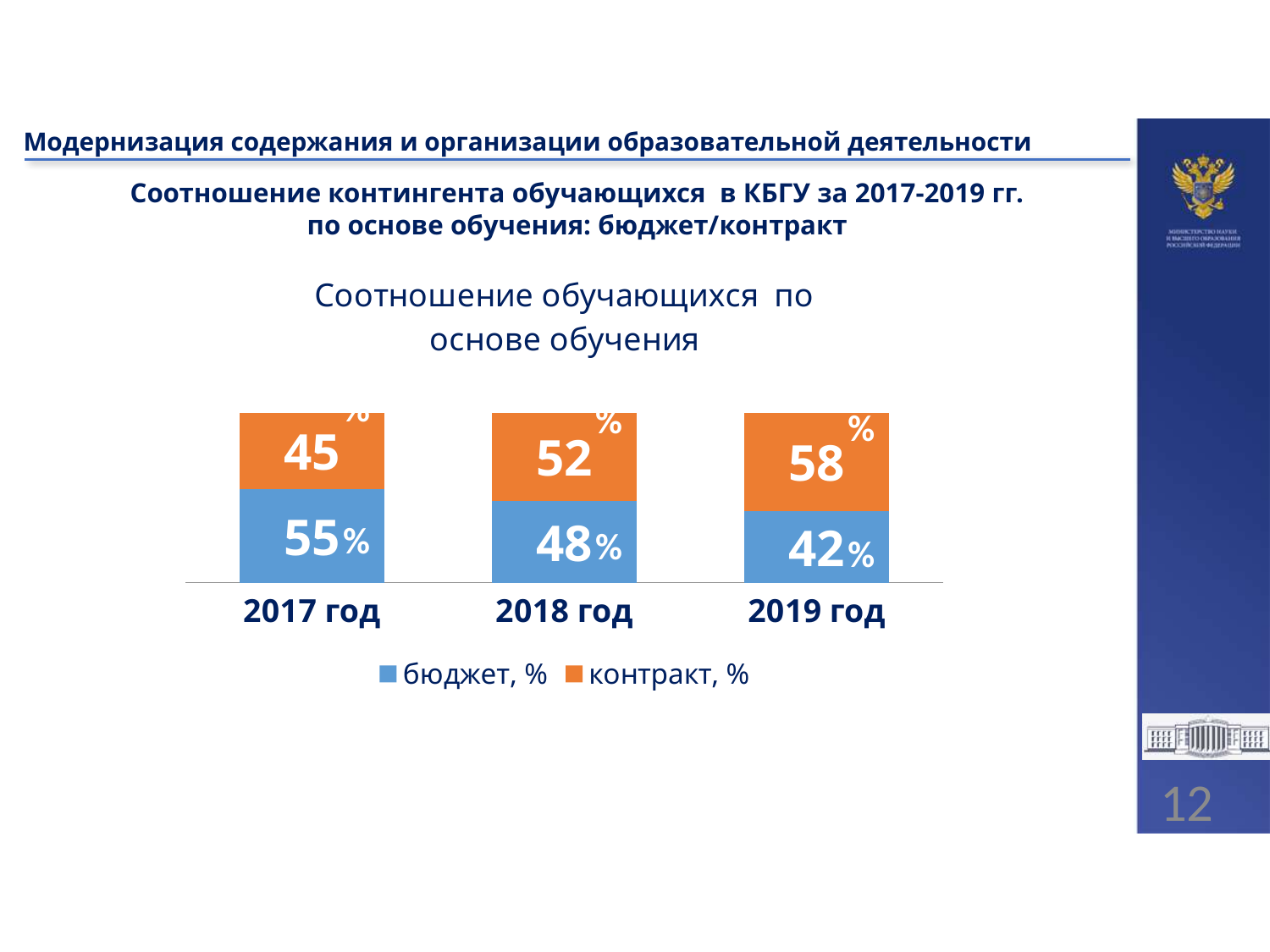
Does the бюджет, % value rise or fall from 2017 год to 2019 год? Fall In which year is the контракт, % value lowest? 2017 год What is the value for бюджет, % in 2017 год? 55% What kind of chart is shown on the slide? Stacked bar chart How many years are shown on the x axis of the chart? 3 How many series does the legend list? 2 In which year is the бюджет, % value highest? 2017 год What is the value for бюджет, % in 2018 год? 48% What is the value for контракт, % in 2019 год? 58% What is the value for контракт, % in 2018 год? 52% Which is larger in 2019 год: бюджет, % or контракт, %? контракт, % What is the difference between the контракт, % values for 2019 год and 2017 год? 13%